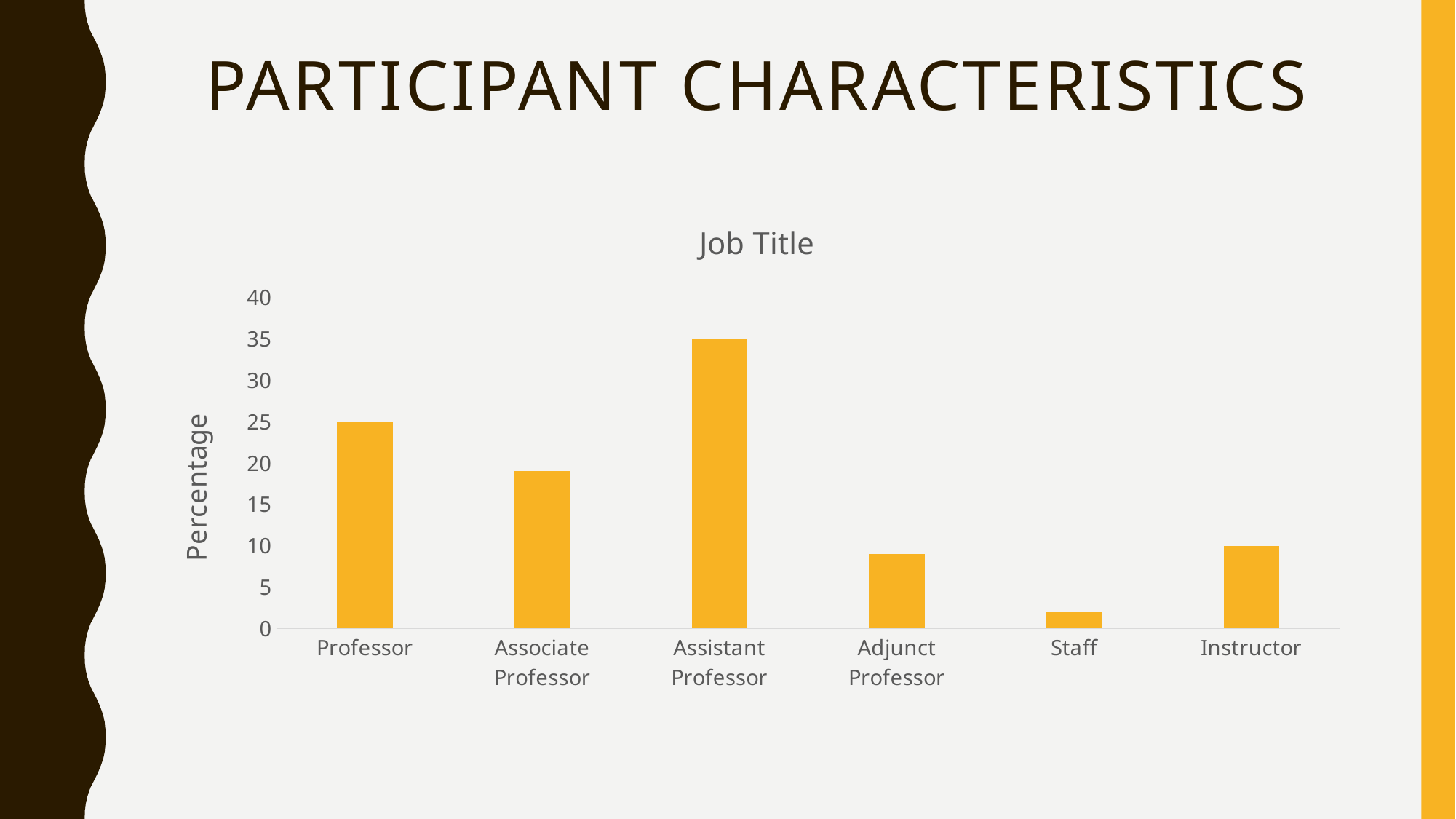
What is the percentage for Professor? 25 How many job title categories are shown in the chart? 6 Is the value for Associate Professor greater or less than 20? less What is the label on the vertical axis of the chart? Percentage Which job title has the lowest percentage? Staff What is the percentage for Assistant Professor? 35 What is the percentage for Instructor? 10 What is the title of the chart? Job Title What type of chart is shown on the slide? bar chart Which is larger, the percentage for Professor or for Associate Professor? Professor Which job title has the highest percentage? Assistant Professor Is the value for Staff greater or less than 5? less